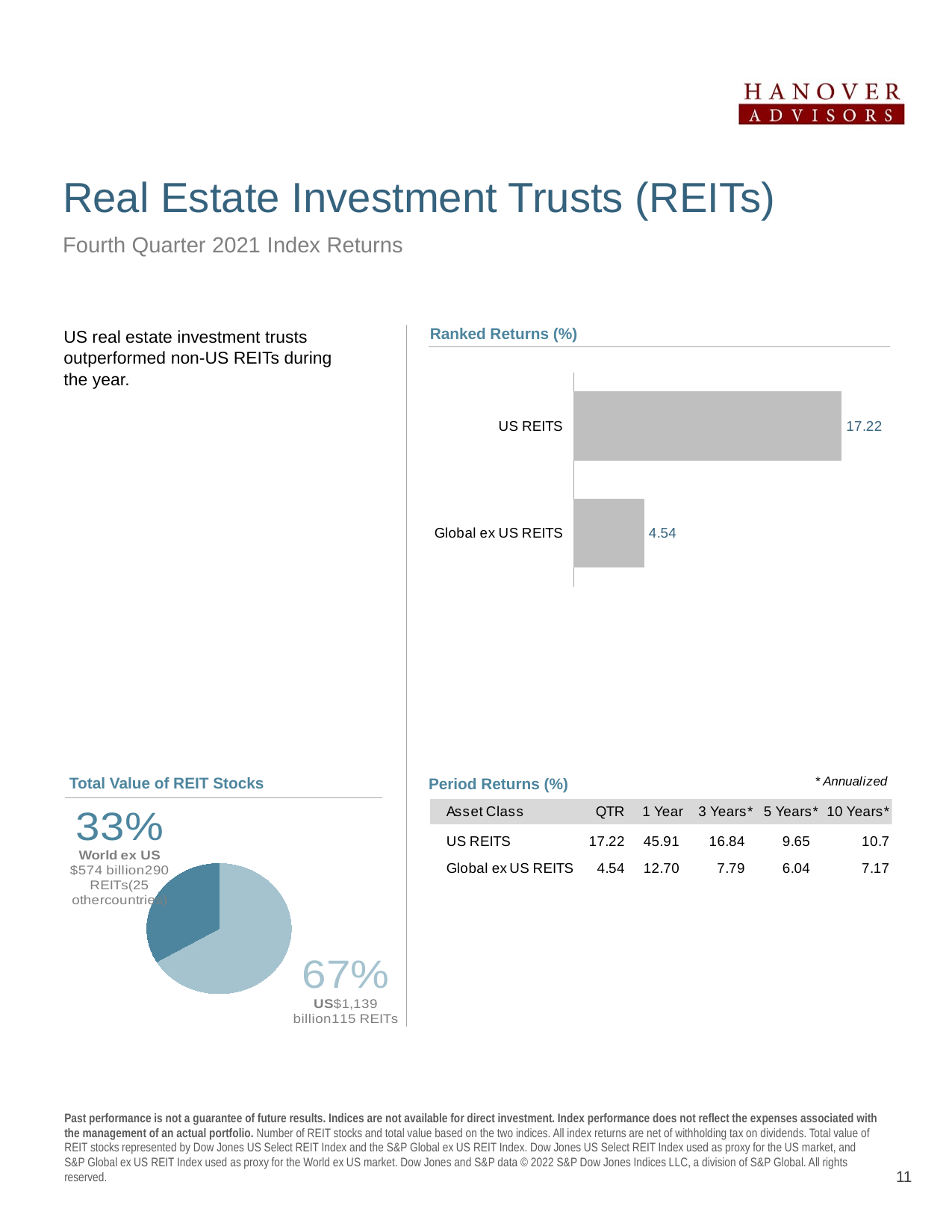
In the Ranked Returns (%) chart, which category has the highest value? US REITS In the Ranked Returns (%) chart, which category has the lowest value? Global ex US REITS What kind of chart is the Total Value of REIT Stocks chart? Pie chart In the Total Value of REIT Stocks chart, what share does the World ex US slice represent? 33% In the Ranked Returns (%) chart, what is the difference between the US REITS and Global ex US REITS values? 12.68 In the Total Value of REIT Stocks chart, what share does the US slice represent? 67% In the Ranked Returns (%) chart, what is the value for Global ex US REITS? 4.54 In the Total Value of REIT Stocks chart, which slice is larger, US or World ex US? US In the Ranked Returns (%) chart, how many categories are plotted? 2 What kind of chart is the Ranked Returns (%) chart? Bar chart In the Ranked Returns (%) chart, what is the value for US REITS? 17.22 In the Total Value of REIT Stocks chart, how many slices does the pie have? 2